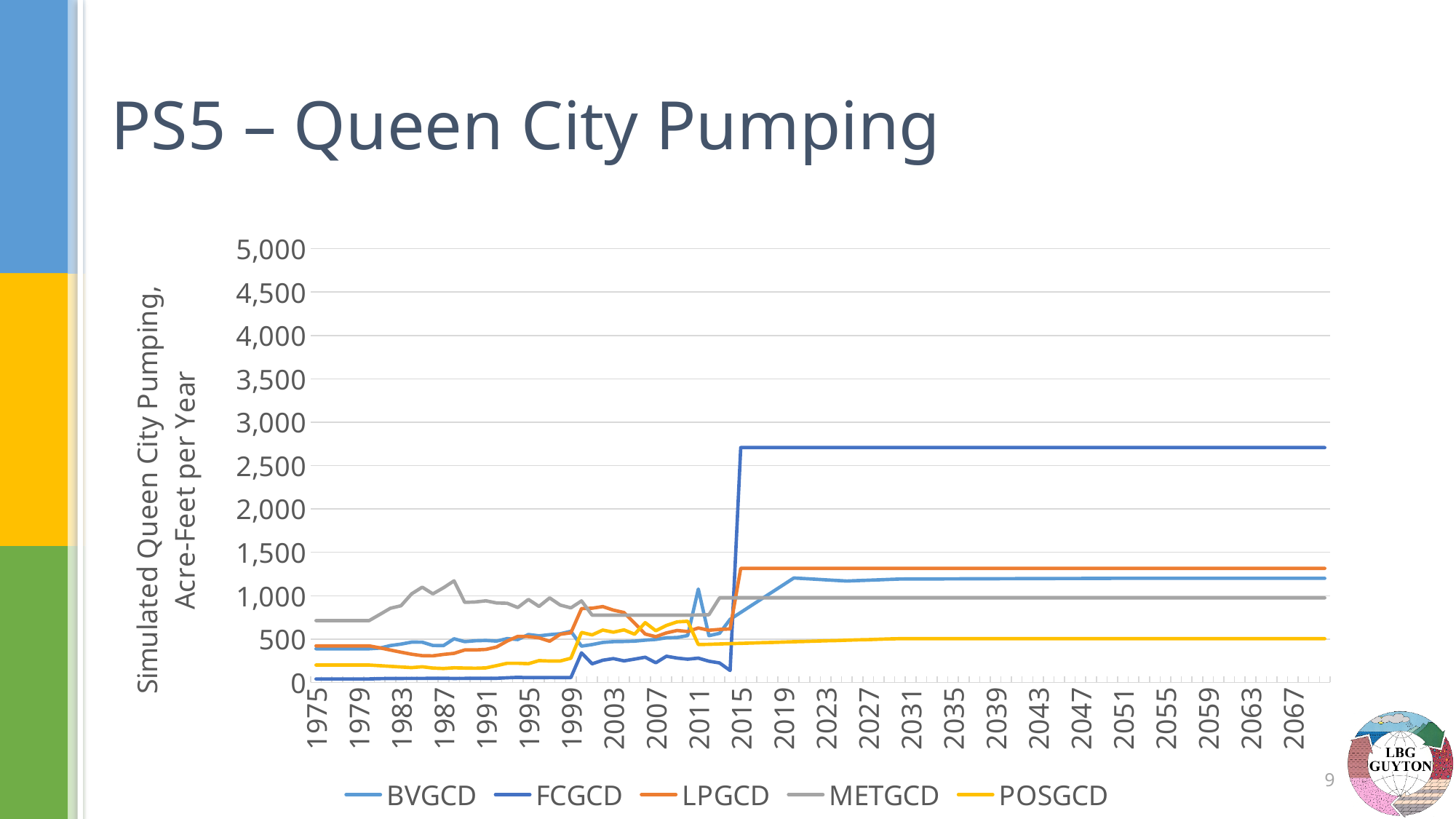
Which series has the highest value in 1975? METGCD Which series has the lowest value in 2067? POSGCD Does the FCGCD series rise or fall between 1975 and 2067? rises Which series has the highest value in 2067? FCGCD How many series does the legend list? 5 In 2067, which is larger: LPGCD or METGCD? LPGCD Is the value for FCGCD in 1975 greater or less than 500? less What kind of chart is shown on the slide? Line chart Is the value for LPGCD in 2067 greater or less than 1,000? greater Is the value for FCGCD in 2067 greater or less than 2,500? greater What is the label on the vertical axis? Simulated Queen City Pumping, Acre-Feet per Year Which series has the lowest value in 1975? FCGCD